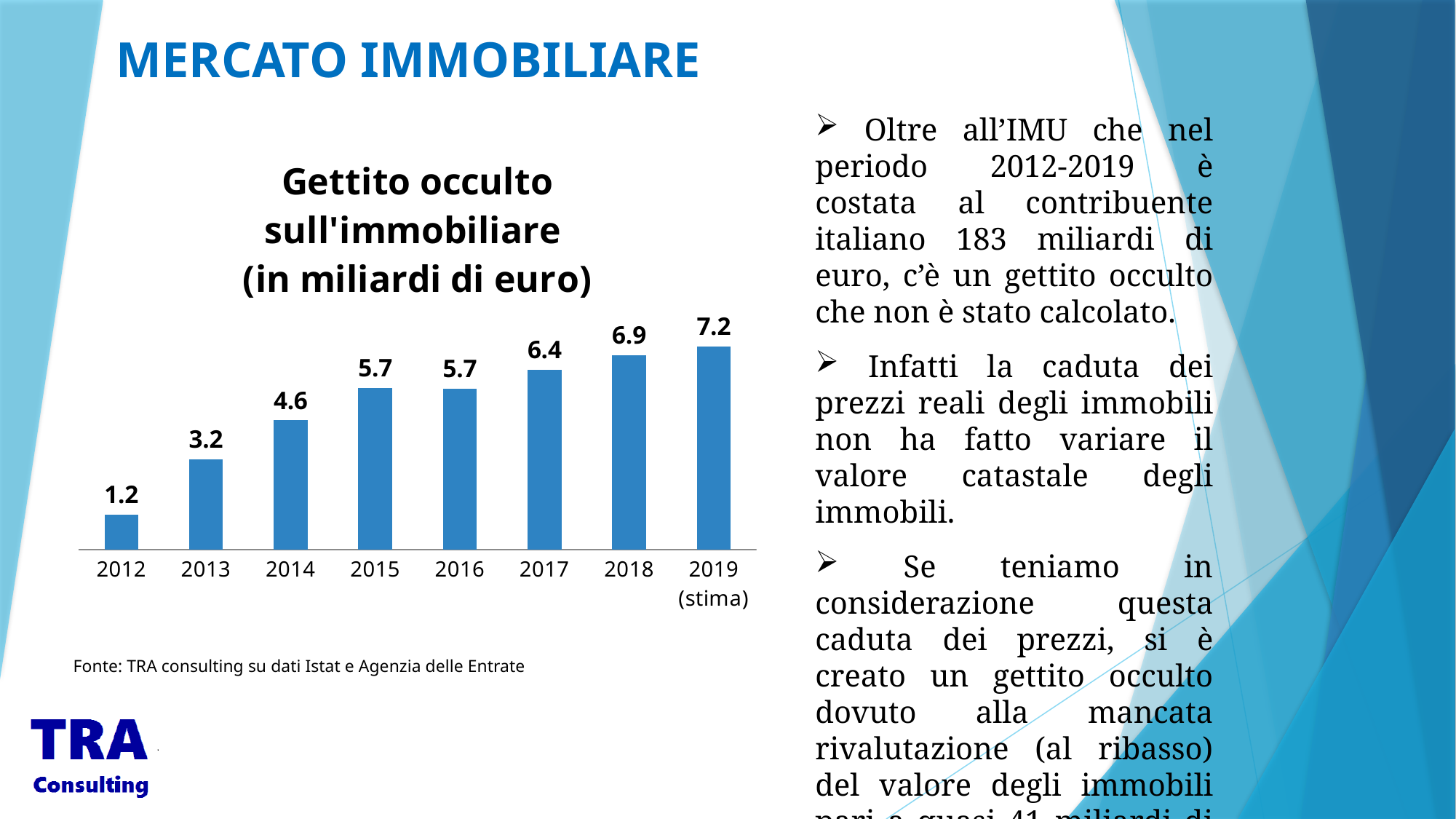
Do the values generally rise or fall from 2012 to 2019? rise What is the value for 2017? 6.4 What is the title of the chart? Gettito occulto sull'immobiliare (in miliardi di euro) What is the value for 2019 (stima)? 7.2 What is the difference between the values for 2014 and 2013? 1.4 What kind of chart is shown? bar chart How many years are shown on the x axis? 8 What is the value for 2012? 1.2 Which year has the highest value? 2019 (stima) Which is larger, the value for 2018 or the value for 2016? 2018 Which year has the lowest value? 2012 What is the difference between the values for 2019 (stima) and 2012? 6.0